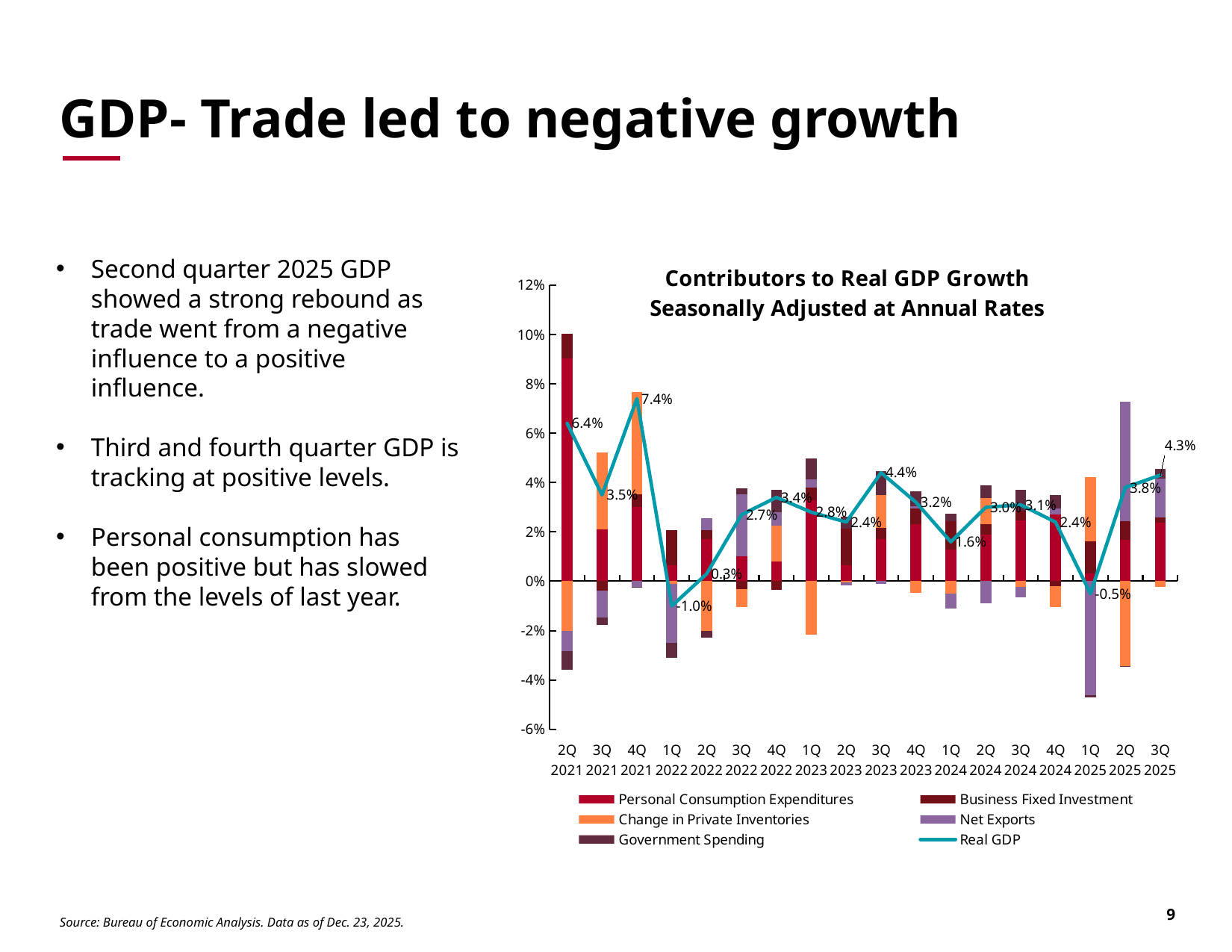
Which quarter had higher Real GDP growth, 3Q 2023 or 4Q 2023? 3Q 2023 Does the Real GDP line rise or fall from 1Q 2025 to 3Q 2025? Rise What kind of chart is used to show the contributors to Real GDP growth? Stacked bar chart with a line for Real GDP What is the Real GDP growth rate shown for 3Q 2025? 4.3% What is the Real GDP growth rate shown for 1Q 2025? -0.5% Which quarter has the highest Real GDP growth rate on the chart? 4Q 2021 Which quarter has the lowest Real GDP growth rate on the chart? 1Q 2022 What is the Real GDP growth rate shown for 1Q 2024? 1.6% How many quarters are shown on the x axis of the chart? 18 What is the difference in Real GDP growth between 3Q 2025 and 2Q 2025? 0.5 percentage points How many series does the chart's legend list? 6 What is the Real GDP growth rate shown for 4Q 2021? 7.4%